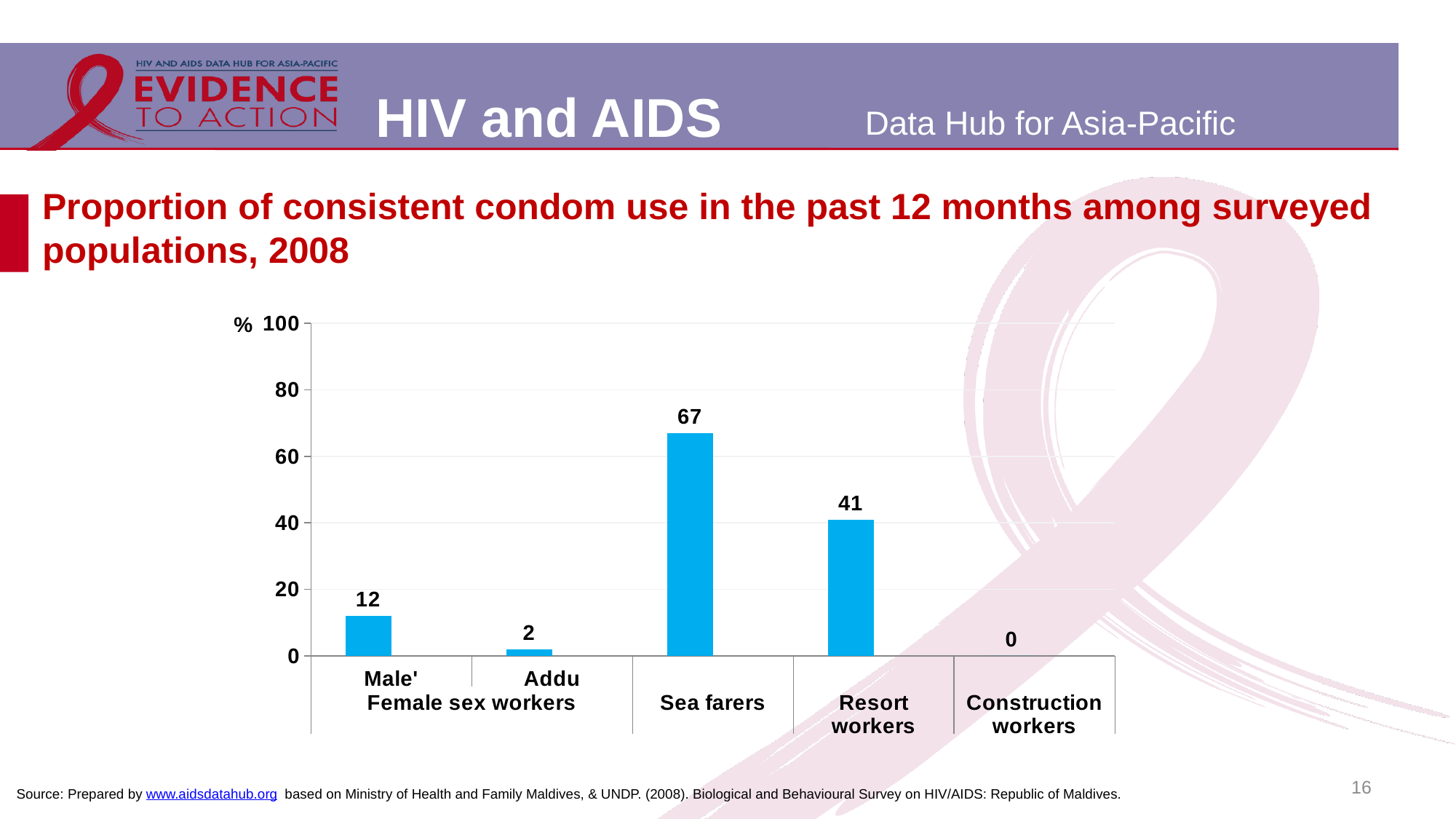
What is the difference between the values for Sea farers and Resort workers? 26 How many bars are plotted in the chart? 5 What kind of chart is shown on the slide? Bar chart What is the value for Resort workers? 41 What is the value for Female sex workers in Addu? 2 What is the value for Female sex workers in Male'? 12 Which is larger, the value for Female sex workers in Male' or in Addu? Male' Which category has the highest value? Sea farers What unit is shown on the y axis of the chart? % What is the value for Sea farers? 67 Which category has the lowest value? Construction workers What is the value for Construction workers? 0